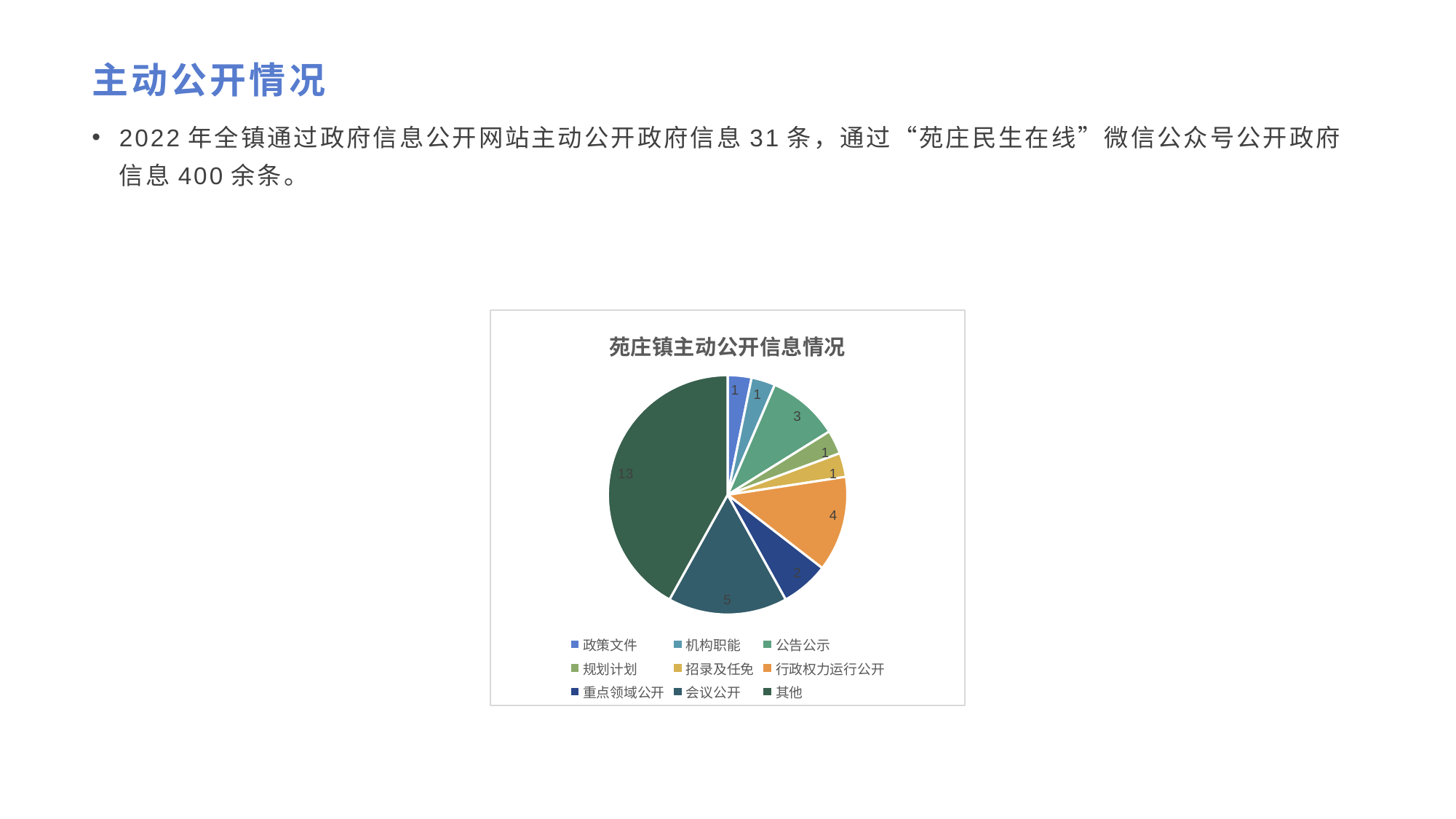
What is the value for 其他 in the pie chart? 13 What is the value for 会议公开 in the pie chart? 5 What is the difference between the values for 其他 and 会议公开? 8 What is the value for 重点领域公开 in the pie chart? 2 What is the title of the chart? 苑庄镇主动公开信息情况 Which category has the largest slice in the pie chart? 其他 What kind of chart is shown on the slide? pie chart What is the value for 公告公示 in the pie chart? 3 Which is larger, the value for 行政权力运行公开 or the value for 重点领域公开? 行政权力运行公开 What is the value for 行政权力运行公开 in the pie chart? 4 How many categories does the legend of the pie chart list? 9 What is the total of all the slice values in the pie chart? 31